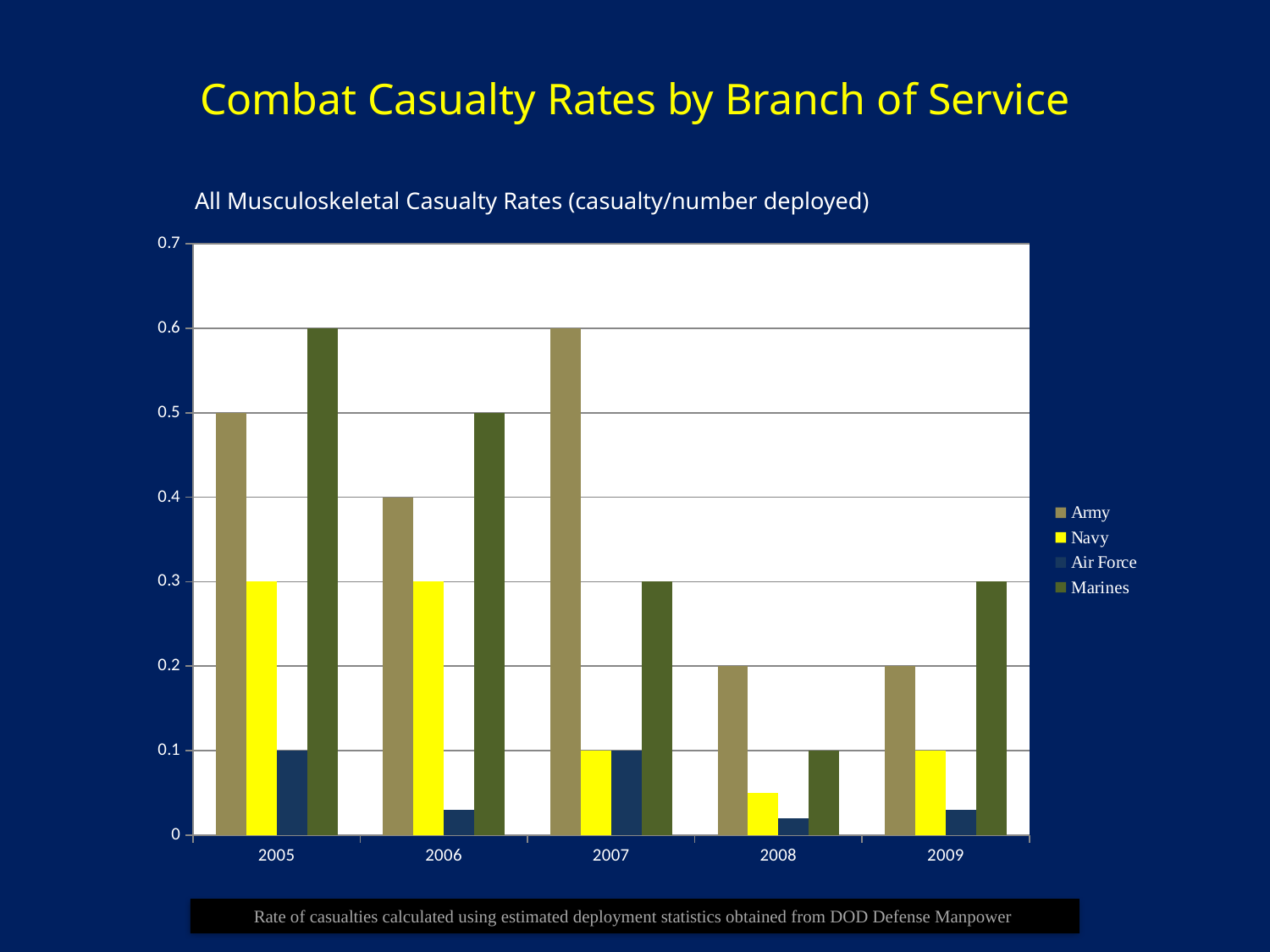
Which series is shown in yellow in the legend? Navy What is the difference between the Army and Navy casualty rates in 2005? 0.2 Is the Navy casualty rate in 2008 greater or less than 0.1? less What is the Army casualty rate in 2007? 0.6 How many series does the legend list? 4 Which branch has the highest casualty rate in 2006? Marines Which branch has the lowest casualty rate in 2008? Air Force How many years are shown on the x axis? 5 What is the Marines casualty rate in 2005? 0.6 Which is larger, the Army rate in 2007 or the Marines rate in 2007? Army What is the Navy casualty rate in 2006? 0.3 What kind of chart is shown on the slide? bar chart